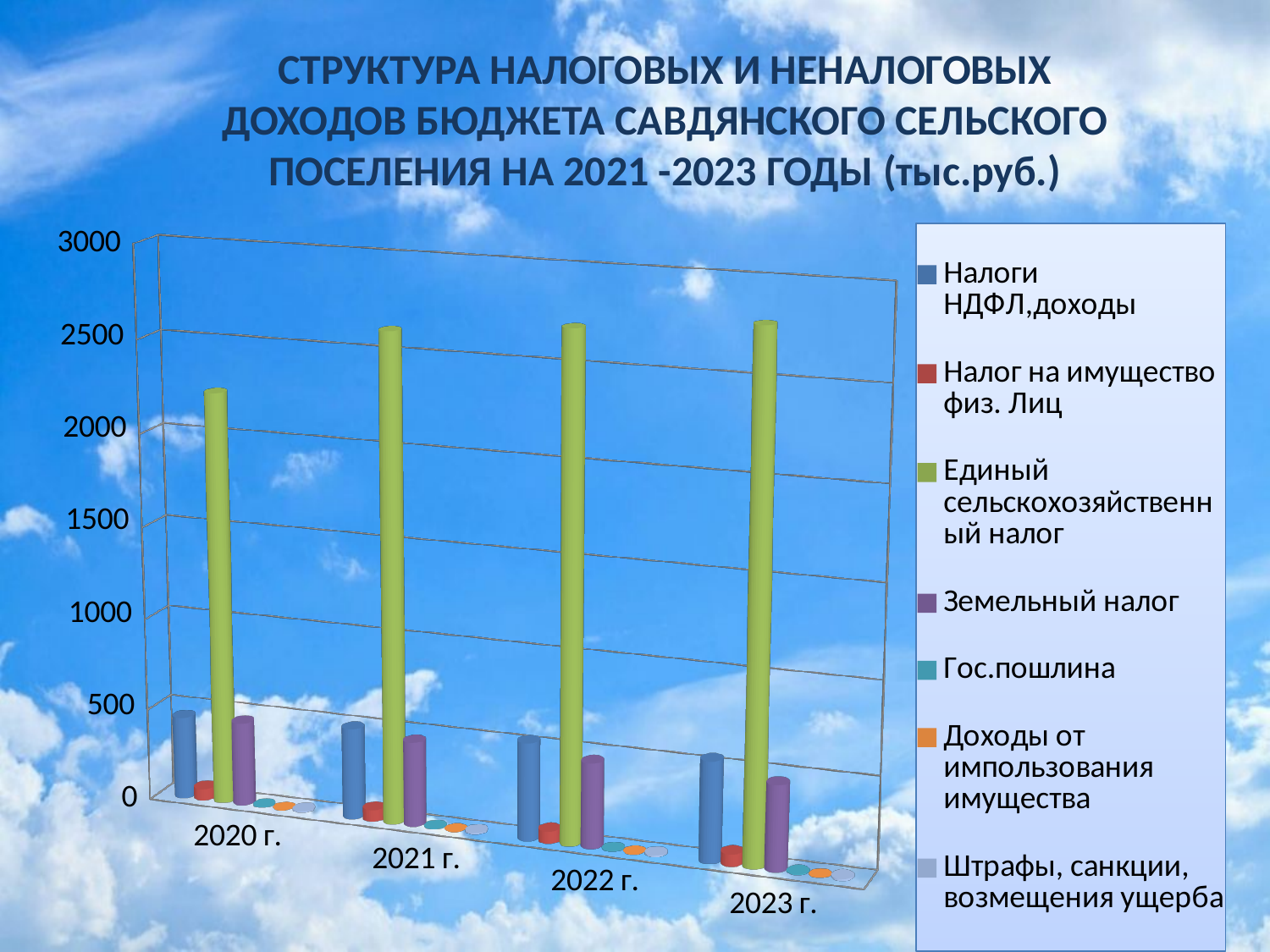
Is the value for Налоги НДФЛ,доходы in 2020 г. greater or less than 500? less Which is larger in 2020 г.: Налоги НДФЛ,доходы or Единый сельскохозяйственный налог? Единый сельскохозяйственный налог Is the value for Единый сельскохозяйственный налог in 2020 г. greater or less than 2000? greater How many years (categories) are shown on the x axis of the chart? 4 What kind of chart is shown on the slide? bar chart Is the value for Единый сельскохозяйственный налог in 2022 г. greater or less than 2000? greater Which series has the highest bar in 2020 г.? Единый сельскохозяйственный налог What colour represents Единый сельскохозяйственный налог in the legend? green How many series does the chart legend list? 7 Which series has the highest bar in 2023 г.? Единый сельскохозяйственный налог